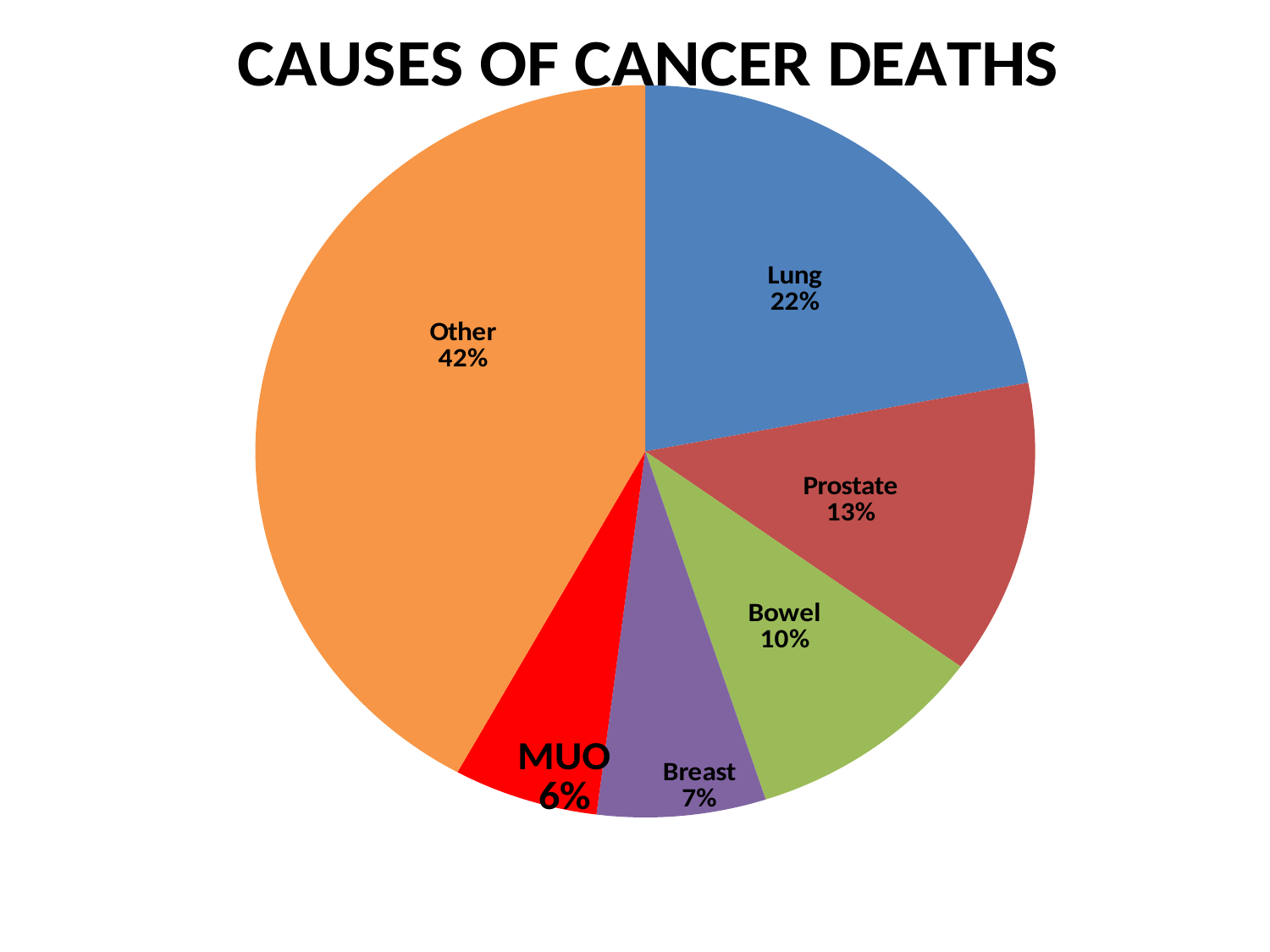
What colour is the MUO slice? Red Which category has the largest slice of the pie? Other What type of chart is shown on the slide? Pie chart What percentage of cancer deaths is attributed to Lung cancer? 22% How many slices does the pie chart have? 6 What is the value shown for the MUO slice? 6% Which is larger, the Breast slice or the Bowel slice? Bowel Which named category has the smallest slice? MUO What share of the pie does Prostate cancer account for? 13% What is the combined share of Lung and Prostate cancer deaths? 35% What is the difference in percentage points between Lung and Bowel? 12 What is the title of the chart? CAUSES OF CANCER DEATHS